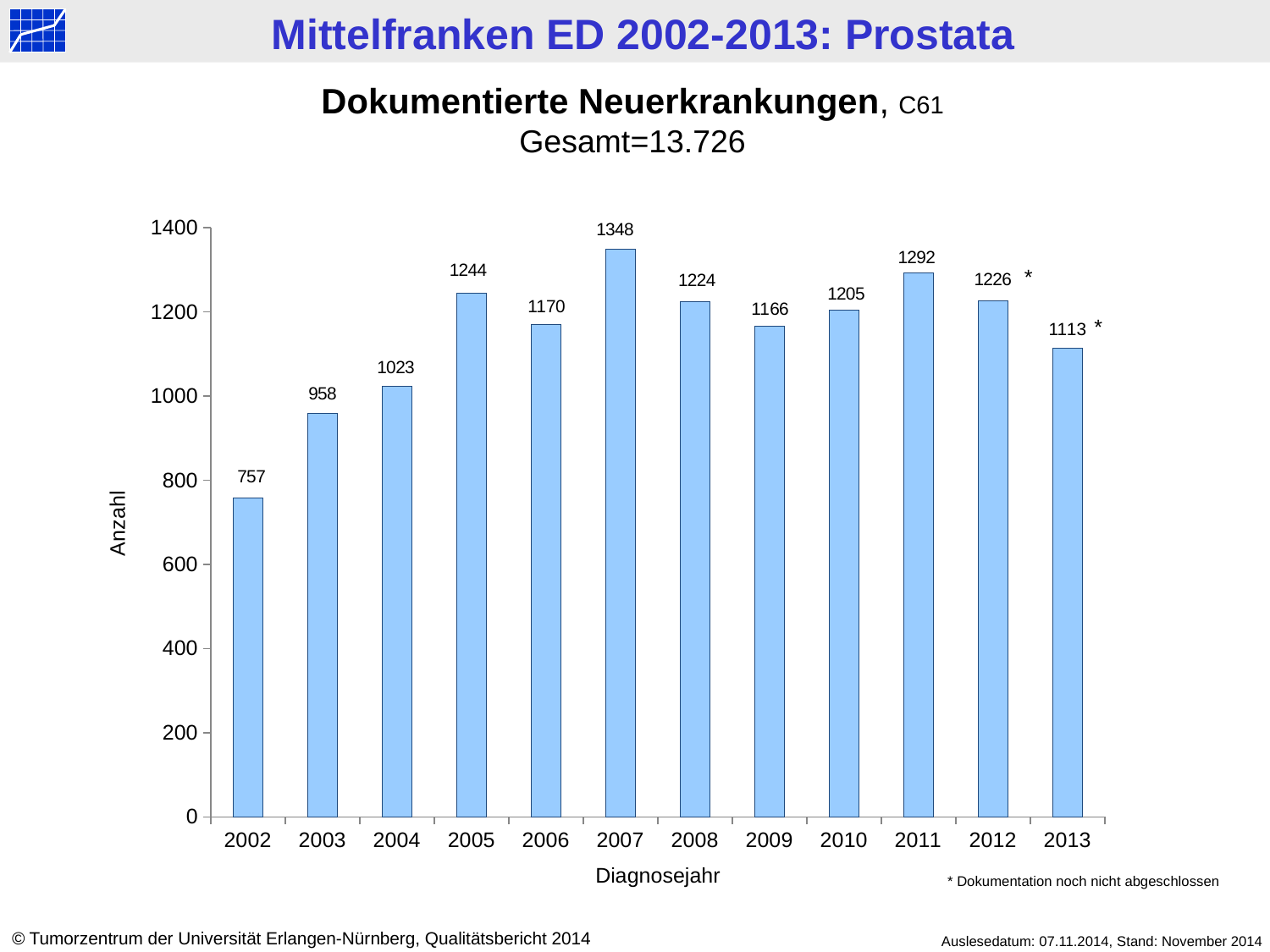
Which is larger, the value for 2005 or the value for 2006? 2005 Which year has the highest value? 2007 How many years are shown on the x axis? 12 What is the difference between the values for 2007 and 2002? 591 What is the value for 2002? 757 Do the values rise or fall from 2002 to 2005? rise What is the label of the y axis? Anzahl Which year has the lowest value? 2002 What kind of chart is shown? bar chart What is the value for 2007? 1348 What is the value for 2013? 1113 Is the value for 2004 greater or less than 1000? greater